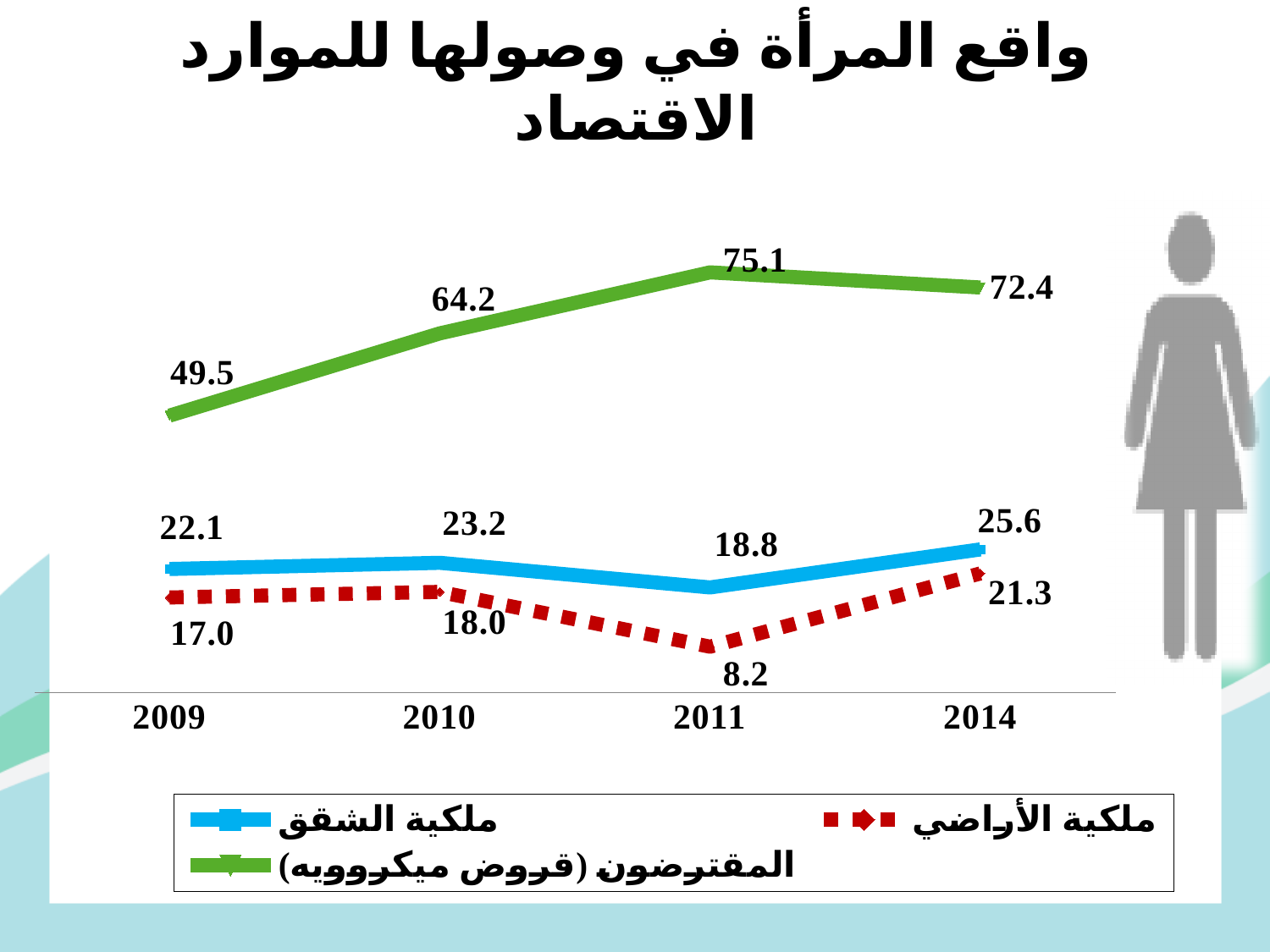
What type of chart is shown on the slide? line chart What is the difference between the المقترضون (قروض ميكروويه) values in 2010 and 2009? 14.7 Does the value for ملكية الأراضي rise or fall from 2011 to 2014? rise Which is larger in 2014: ملكية الشقق or ملكية الأراضي? ملكية الشقق In which year is the value for المقترضون (قروض ميكروويه) highest? 2011 What is the value for ملكية الشقق in 2014? 25.6 How many series does the legend list? 3 What is the value for المقترضون (قروض ميكروويه) in 2011? 75.1 In which year is the value for ملكية الأراضي lowest? 2011 What is the value for ملكية الأراضي in 2011? 8.2 How many years are shown on the x axis? 4 Which series is drawn with a red dashed line? ملكية الأراضي